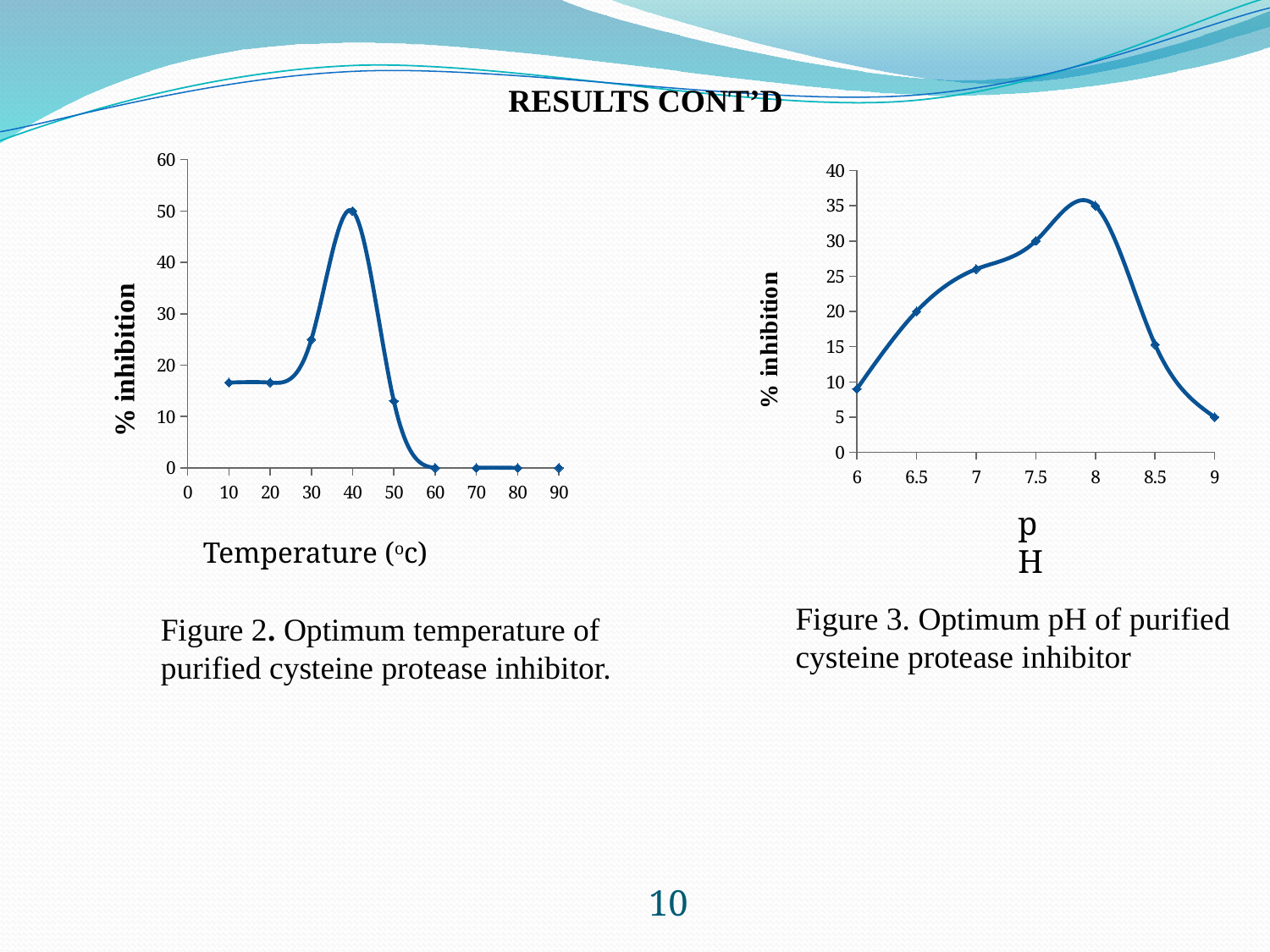
In Figure 2 (the left chart), at which temperature is % inhibition highest? 40 In Figure 2 (the left chart), what is the % inhibition at 70 °C? 0 In Figure 2 (the left chart), how many data points are plotted? 9 In Figure 3 (the right chart), at which pH is % inhibition highest? 8 In Figure 2 (the left chart), what is the % inhibition at 40 °C? 50 In Figure 3 (the right chart), at which pH is % inhibition lowest? 9 What is the y-axis label of Figure 3 (the right chart)? % inhibition In Figure 2 (the left chart), does % inhibition rise or fall between 40 °C and 60 °C? fall What kind of chart is Figure 2 (the left chart)? line chart In Figure 2 (the left chart), is the % inhibition at 30 °C greater or less than 20? greater In Figure 3 (the right chart), which has the higher % inhibition, pH 6.5 or pH 7.5? pH 7.5